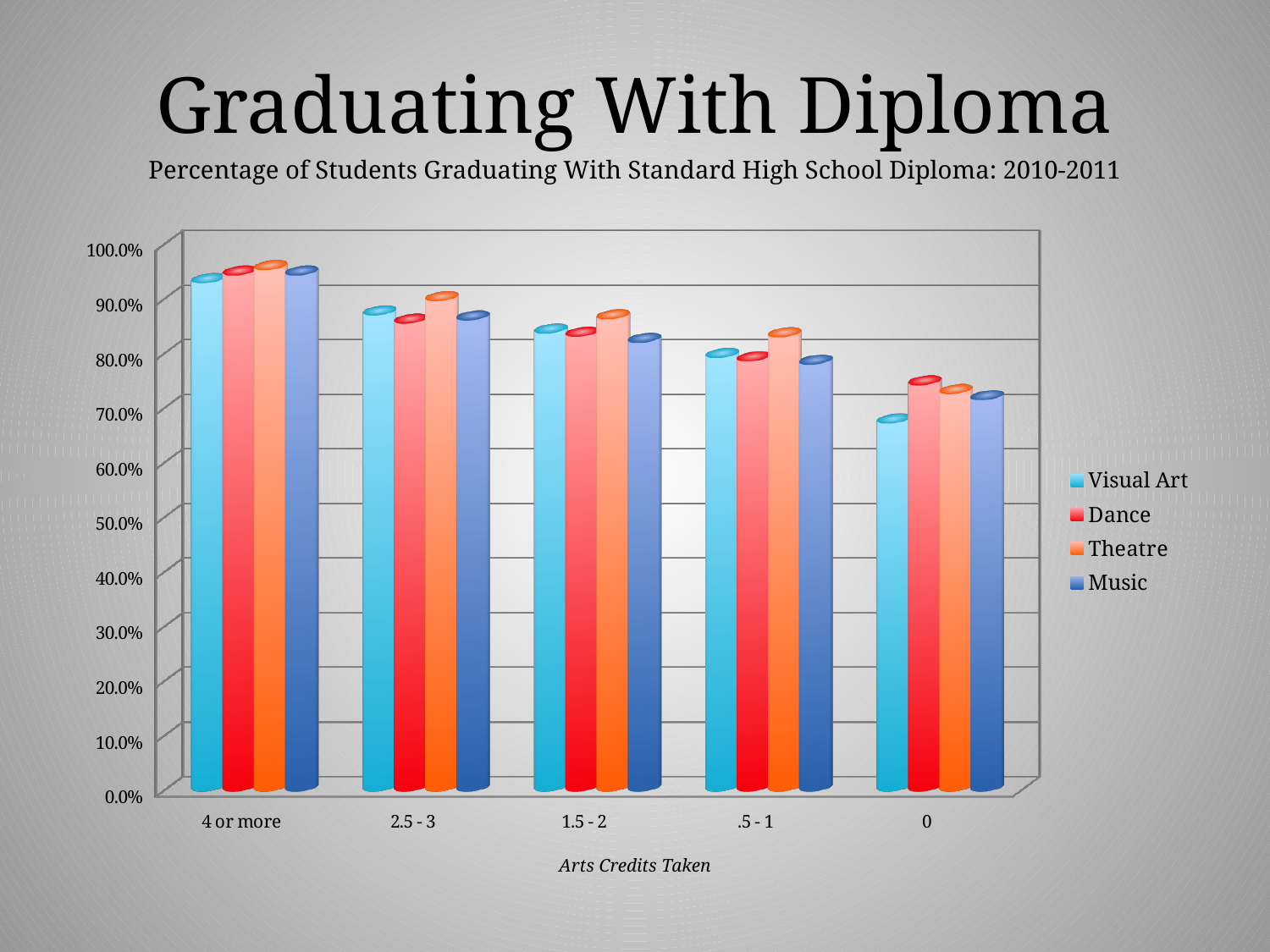
What kind of chart is shown on the slide? bar chart In the ".5 - 1" credits category, which is larger: Theatre or Visual Art? Theatre Do the Visual Art values rise or fall moving from "4 or more" to "0" credits? fall Is the Visual Art value for "0" credits greater or less than 80%? less In which category is the Theatre value highest? 4 or more What is the title of the x axis? Arts Credits Taken Is the Music value for "1.5 - 2" credits greater or less than 90%? less How many series does the legend list? 4 Is the Theatre value for ".5 - 1" credits greater or less than 80%? greater Which series has the lowest value in the "0" credits category? Visual Art How many categories are shown on the x axis? 5